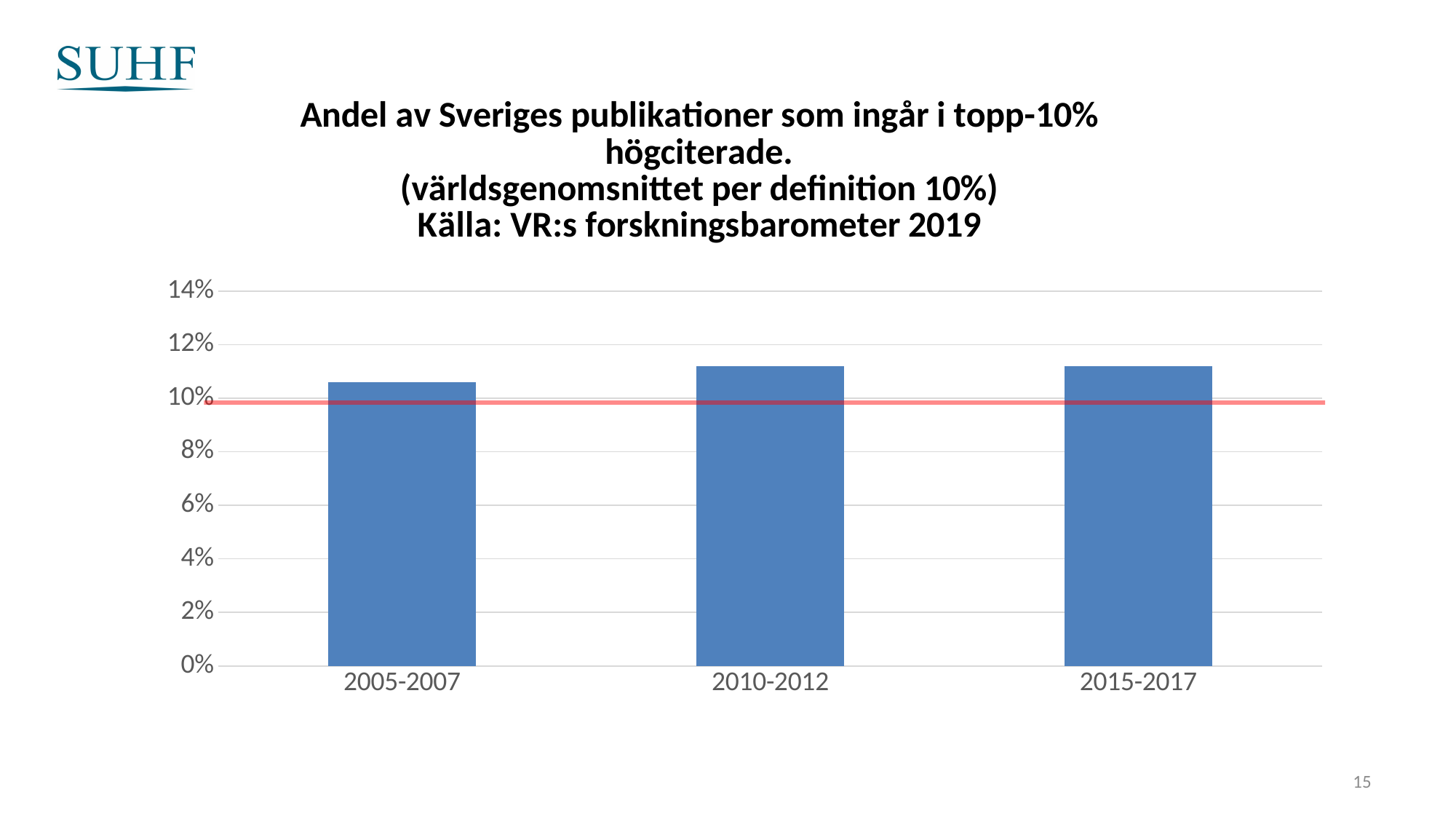
What kind of chart is shown on the slide? bar chart How many time periods are shown on the x axis of the chart? 3 Does the share of highly cited publications rise or fall from 2005-2007 to 2015-2017? rise Which is larger, the value for 2005-2007 or the value for 2010-2012? 2010-2012 Is the value for 2005-2007 greater or less than 12%? less At what value on the y axis is the horizontal red reference line drawn? 10% Is the value for 2015-2017 greater or less than 10%? greater Which is larger, the value for 2015-2017 or the value for 2005-2007? 2015-2017 What source is cited in the chart title? VR:s forskningsbarometer 2019 Is the value for 2010-2012 greater or less than 12%? less Which period has the lowest share of publications in the top-10% highly cited? 2005-2007